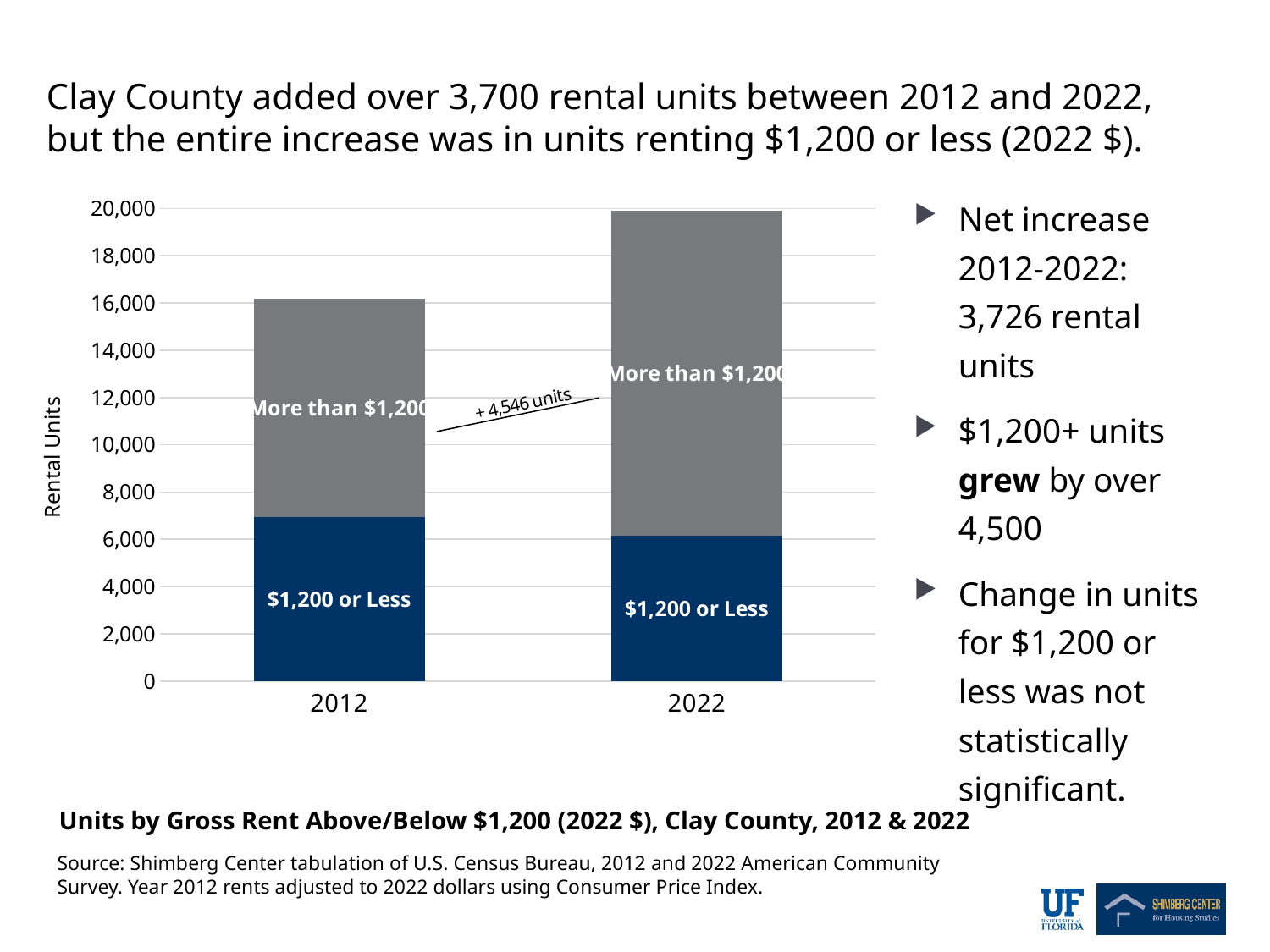
What kind of chart is shown on the slide? Stacked bar chart How many years (categories) are shown on the x axis of the chart? 2 Does the total number of rental units rise or fall from 2012 to 2022? rise Is the '$1,200 or Less' segment for 2022 greater or less than 8,000 units? less Is the total number of rental units in 2022 greater or less than 18,000? greater Is the total number of rental units in 2012 greater or less than 14,000? greater According to the annotation on the chart, by how many units did the 'More than $1,200' segment grow between 2012 and 2022? + 4,546 units What is the title of the chart? Units by Gross Rent Above/Below $1,200 (2022 $), Clay County, 2012 & 2022 Which year has the taller total bar, 2012 or 2022? 2022 How many rent segments is each bar in the chart divided into? 2 What is the label on the y axis of the chart? Rental Units